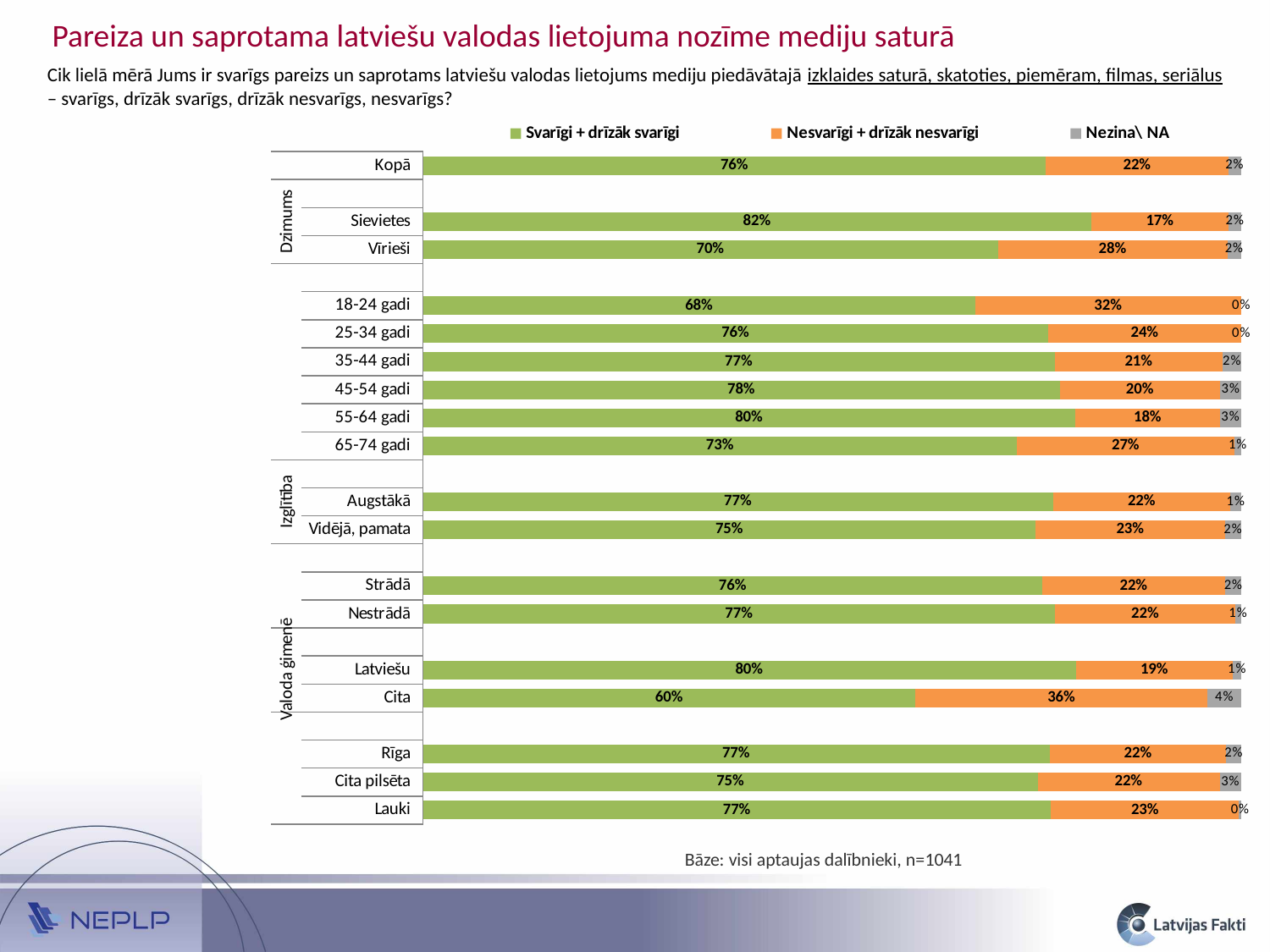
What is the "Svarīgi + drīzāk svarīgi" value for Latviešu? 80% Which category has the highest "Svarīgi + drīzāk svarīgi" value? Sievietes What is the value of "Nesvarīgi + drīzāk nesvarīgi" for Vīrieši? 28% What kind of chart is shown on the slide? Stacked bar chart Which category has the lowest "Svarīgi + drīzāk svarīgi" value? Cita How many series does the legend list? 3 Which category has the highest "Nesvarīgi + drīzāk nesvarīgi" value? Cita How many categories are plotted in the chart? 18 What is the difference between the "Svarīgi + drīzāk svarīgi" values for Sievietes and Vīrieši? 12 percentage points What is the value of "Svarīgi + drīzāk svarīgi" for Kopā? 76% Which has a larger "Svarīgi + drīzāk svarīgi" value, 18-24 gadi or 55-64 gadi? 55-64 gadi What is the "Nezina\ NA" value for Cita? 4%